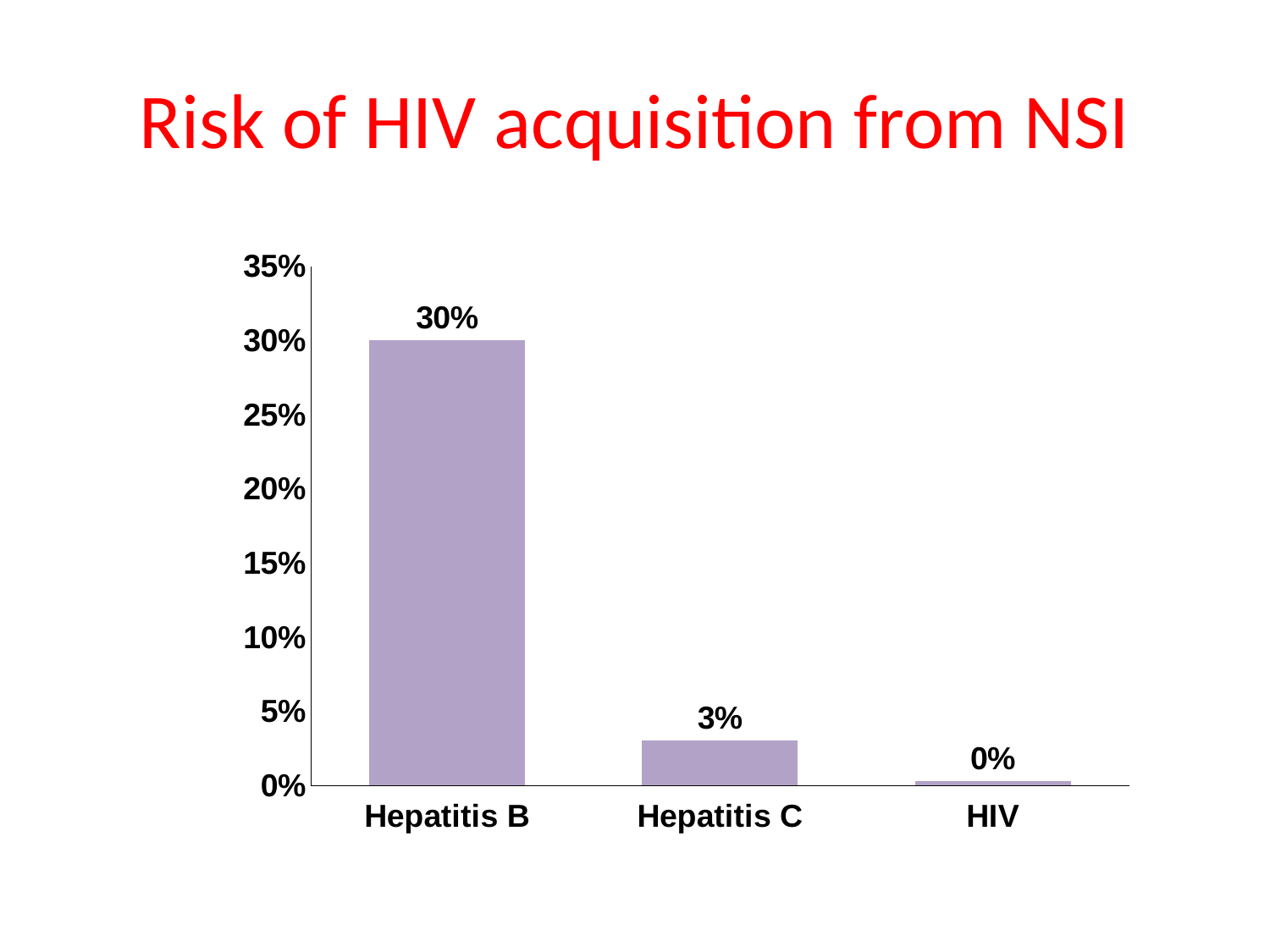
Which category has the highest value? Hepatitis B What is the value for HIV? 0% What kind of chart is shown on the slide? Bar chart How many categories are shown on the x axis? 3 What is the difference between the values for Hepatitis B and Hepatitis C? 27% Is the value for Hepatitis C greater or less than 5%? less What is the value for Hepatitis C? 3% What is the value for Hepatitis B? 30% Is the value for Hepatitis B greater or less than 25%? greater Which is larger, the value for Hepatitis C or the value for HIV? Hepatitis C Which category has the lowest value? HIV What is the title of the slide? Risk of HIV acquisition from NSI